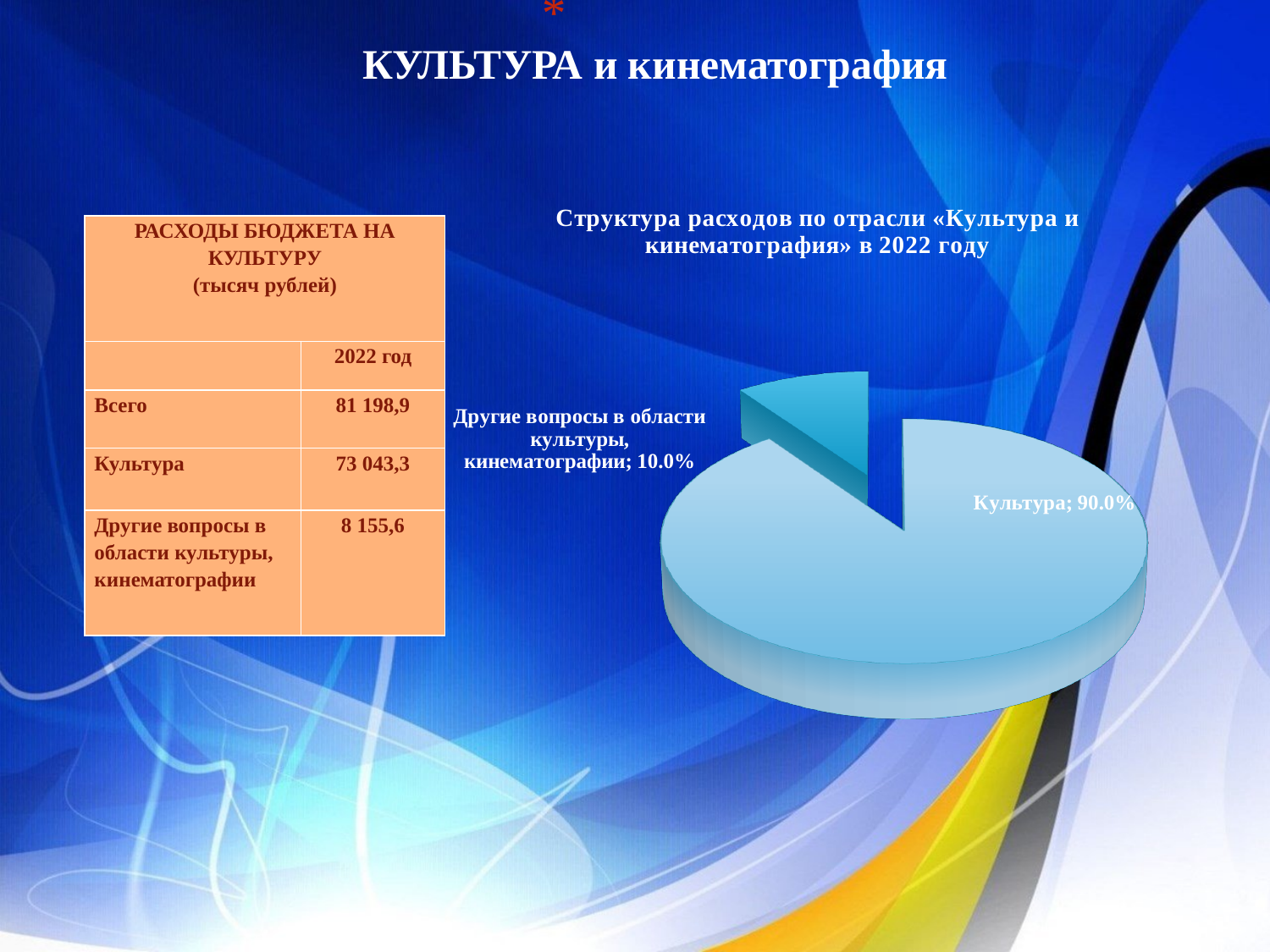
Which slice of the pie chart is the smallest? Другие вопросы в области культуры, кинематографии What is the title of the pie chart? Структура расходов по отрасли «Культура и кинематография» в 2022 году What share of the pie does the slice "Культура" represent? 90.0% Is the share of the "Культура" slice greater or less than 50%? greater Which is larger in the pie chart: the "Культура" slice or the "Другие вопросы в области культуры, кинематографии" slice? Культура What is the difference in percentage points between the "Культура" slice and the "Другие вопросы в области культуры, кинематографии" slice? 80.0 percentage points What kind of chart is shown on the slide? pie chart Which year does the pie chart describe? 2022 What share of the pie does the slice "Другие вопросы в области культуры, кинематографии" represent? 10.0% How many slices does the pie chart have? 2 Which slice of the pie chart is the largest? Культура